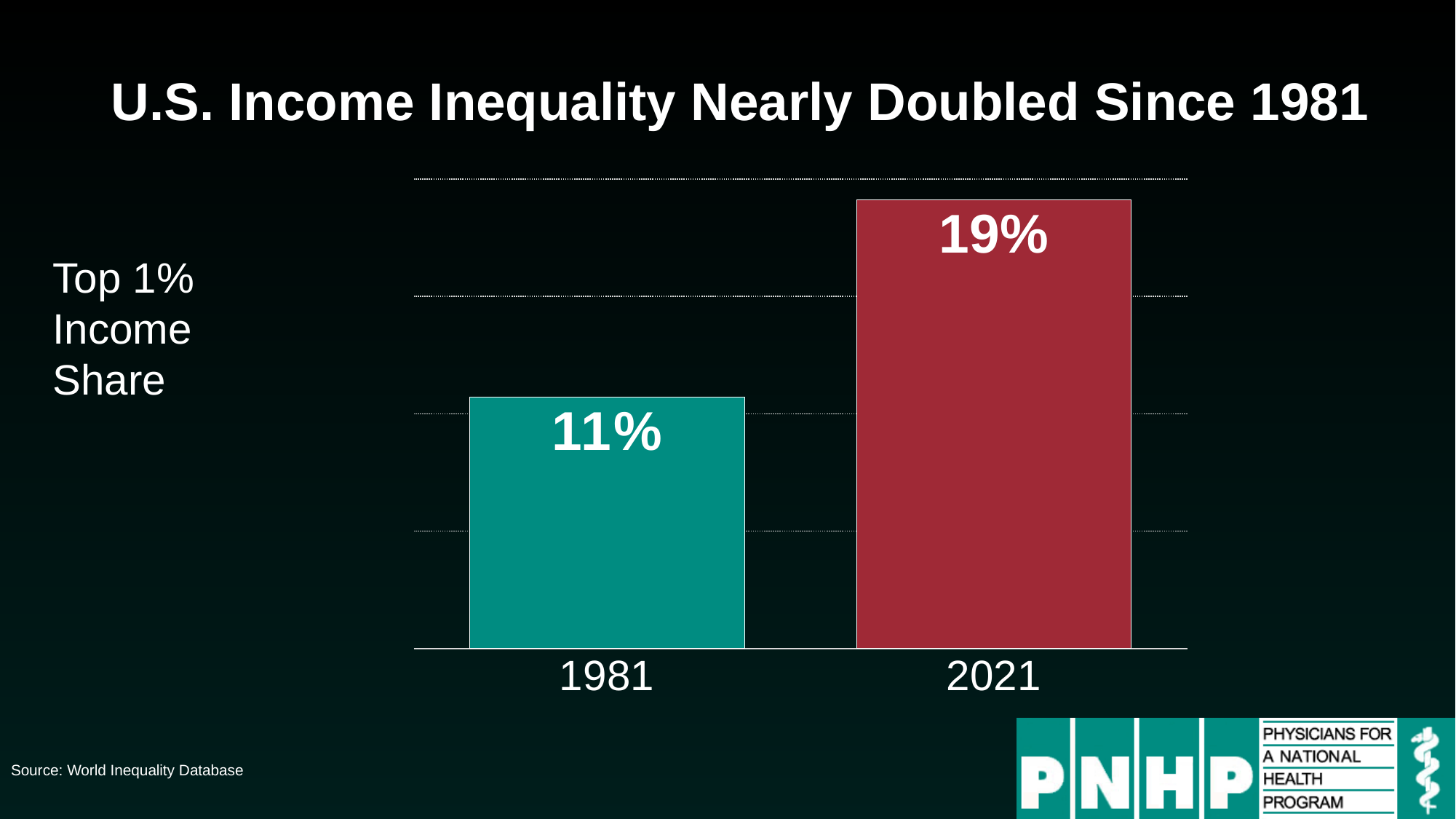
Which year has the lower top 1% income share? 1981 Which year has the higher top 1% income share? 2021 What kind of chart is shown on the slide? bar chart What is the title of the slide? U.S. Income Inequality Nearly Doubled Since 1981 What is the source cited for the chart data? World Inequality Database What is the top 1% income share shown for 1981? 11% How many years (categories) are plotted on the chart? 2 Does the top 1% income share rise or fall from 1981 to 2021? rise What is the top 1% income share shown for 2021? 19% By how many percentage points did the top 1% income share increase from 1981 to 2021? 8 percentage points Is the value for 2021 larger or smaller than the value for 1981? larger